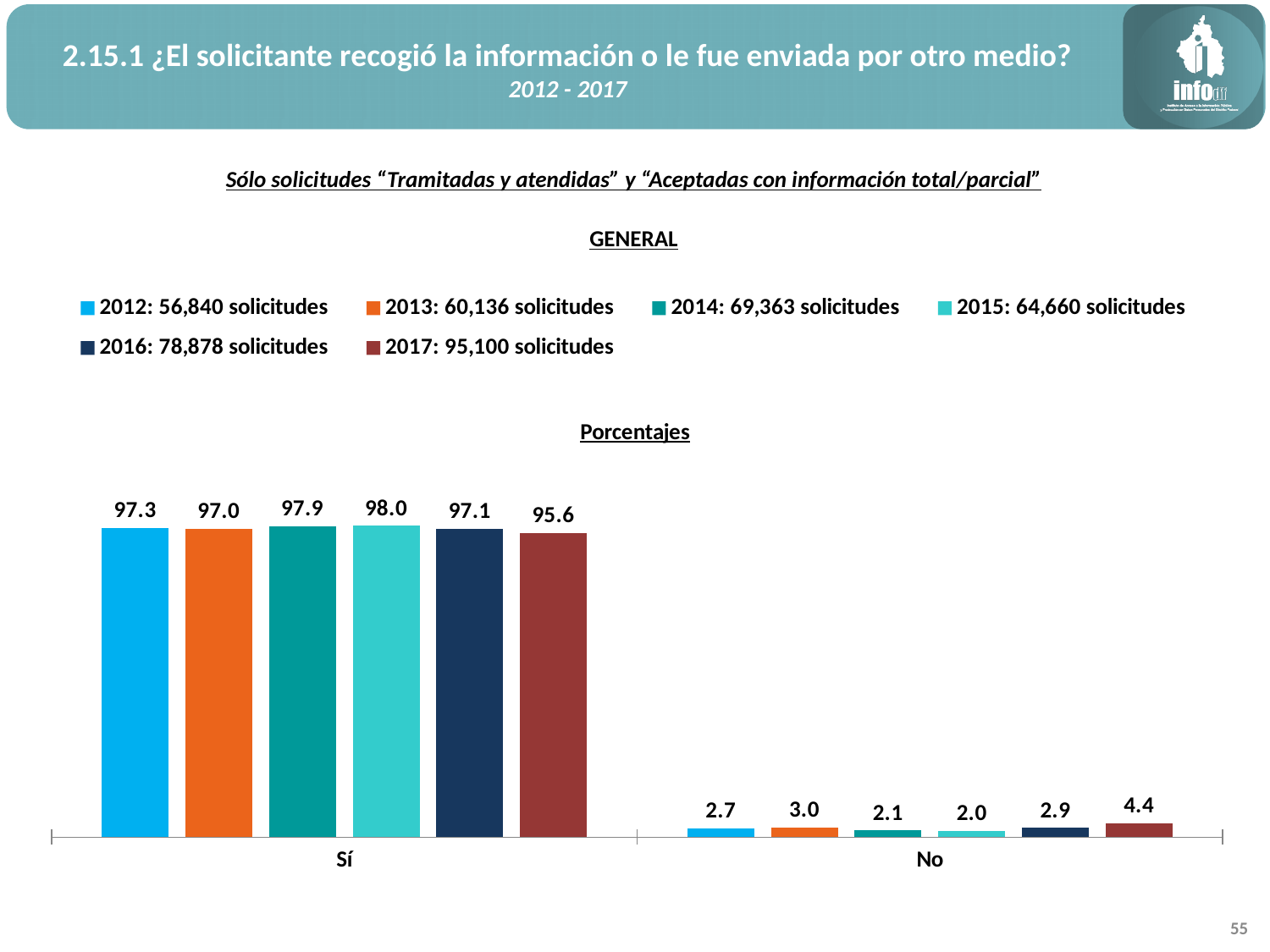
What is the value for 2015 in the Sí category? 98.0 How many series does the legend list? 6 What is the difference between the 2015 and 2017 values in the Sí category? 2.4 Which year has the lowest value in the No category? 2015 Which year has the highest value in the Sí category? 2015 How many categories are shown on the x axis? 2 What is the value for 2017 in the No category? 4.4 According to the legend, how many solicitudes were there in 2017? 95,100 solicitudes Which year has the highest value in the No category? 2017 What is the value for 2012 in the Sí category? 97.3 What kind of chart is shown on the slide? Bar chart Which is larger: the 2013 value or the 2016 value in the No category? 2013